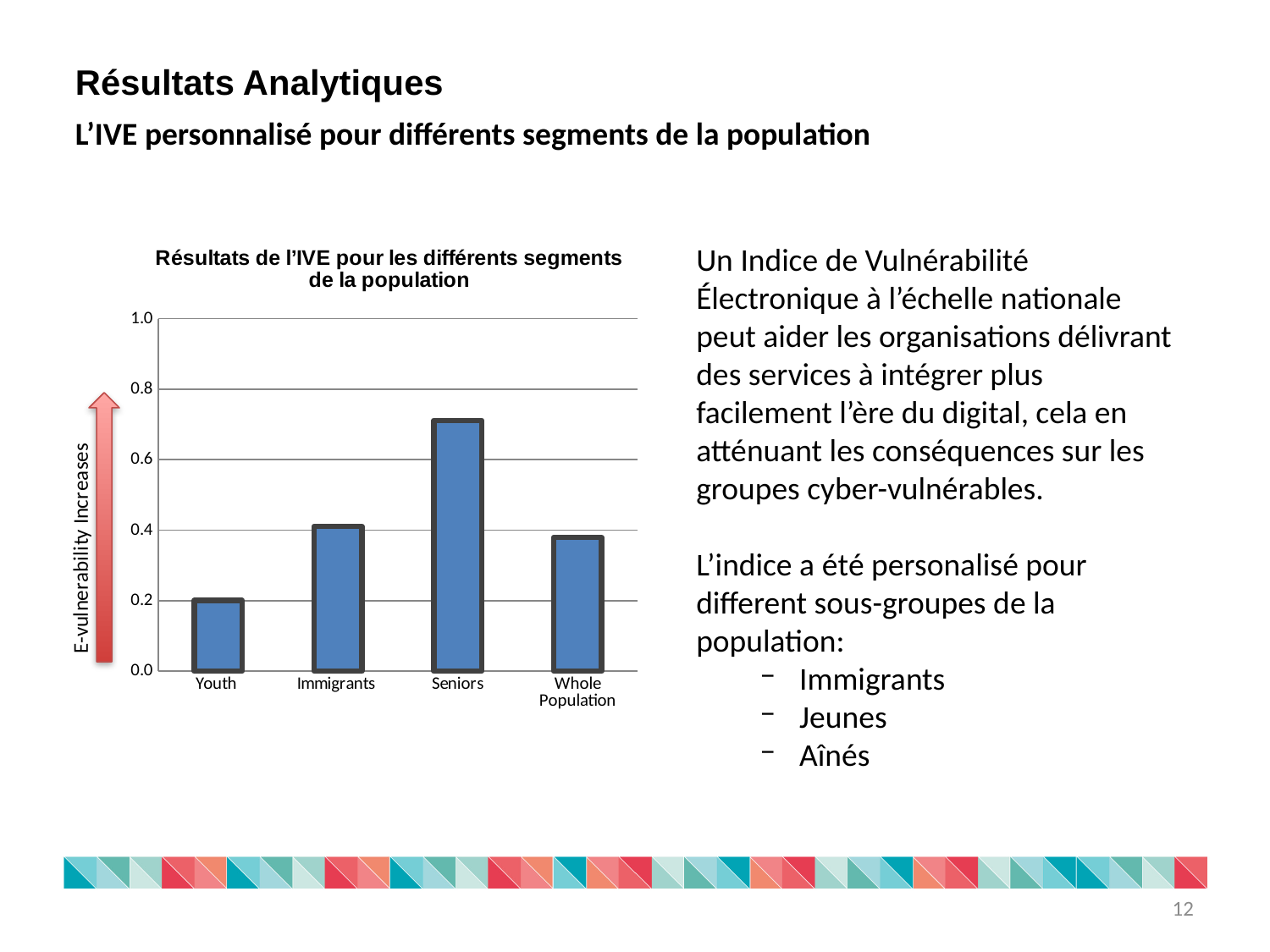
What is the label on the vertical axis of the chart? E-vulnerability Increases Which has a higher value, Seniors or Youth? Seniors Is the value for Immigrants greater or less than 0.6? less How many population segments are plotted in the chart? 4 Which has a higher value, Immigrants or Youth? Immigrants Is the value for Whole Population greater or less than 0.2? greater Is the value for Seniors greater or less than 0.6? greater Which population segment has the highest e-vulnerability value? Seniors What is the title of the chart? Résultats de l'IVE pour les différents segments de la population Which population segment has the lowest e-vulnerability value? Youth What kind of chart is shown on the slide? bar chart